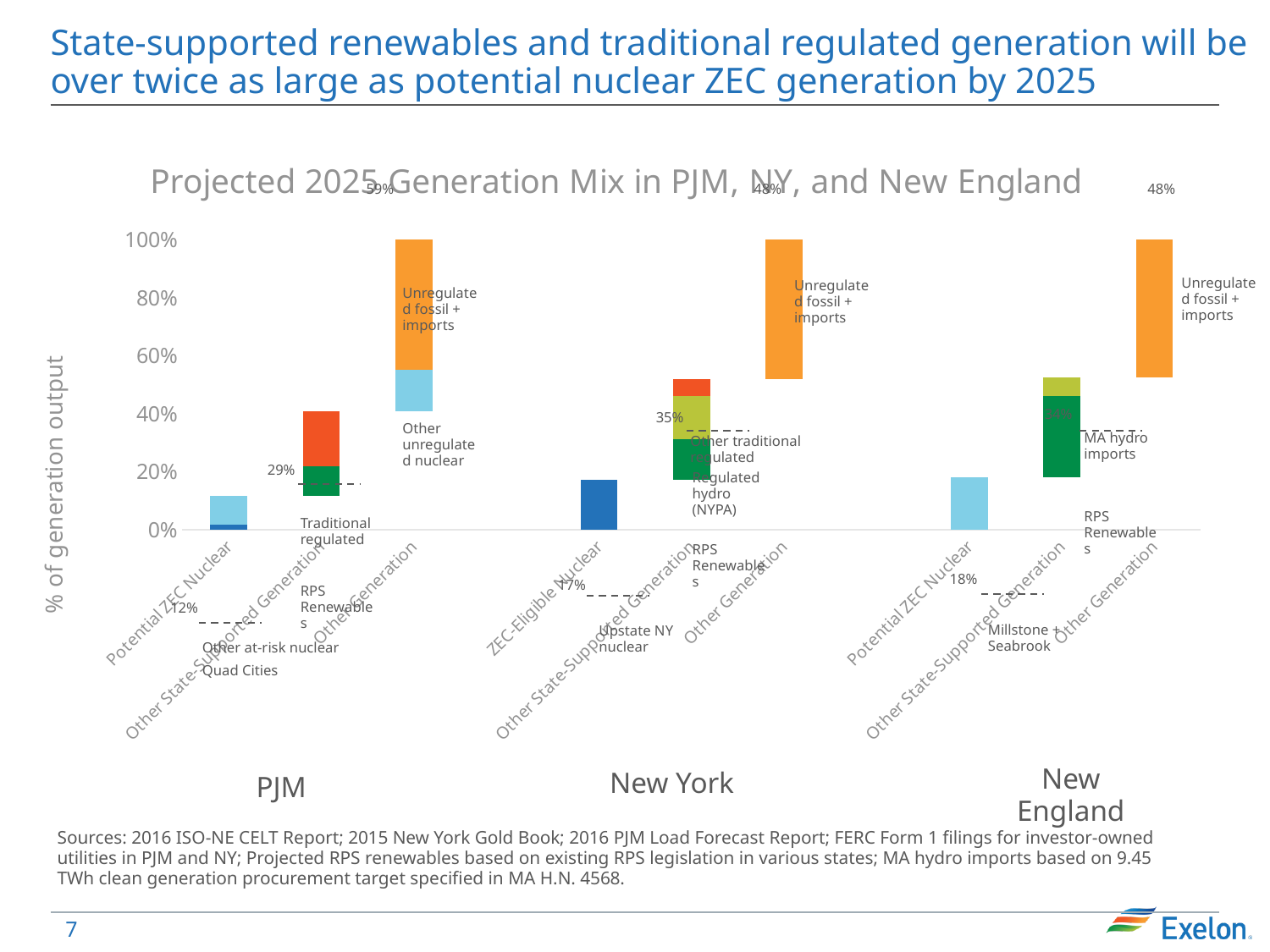
In the PJM chart, which category has the highest value? Other Generation In the PJM chart, what is the value for Other State-Supported Generation? 29% In the New York chart, which is larger: ZEC-Eligible Nuclear or Other State-Supported Generation? Other State-Supported Generation In the PJM chart, what is the value for Other Generation? 59% In the New York chart, what is the value for Other State-Supported Generation? 35% What type of chart is used on this slide? Bar chart In the PJM chart, what is the difference between Other Generation and Potential ZEC Nuclear? 47 percentage points In the New York chart, what is the value for Other Generation? 48% In the PJM chart, what is the value for Potential ZEC Nuclear? 12% In the New England chart, what is the value for Other Generation? 48% In the New York chart, what is the value for ZEC-Eligible Nuclear? 17% In the New England chart, what is the value for Potential ZEC Nuclear? 18%